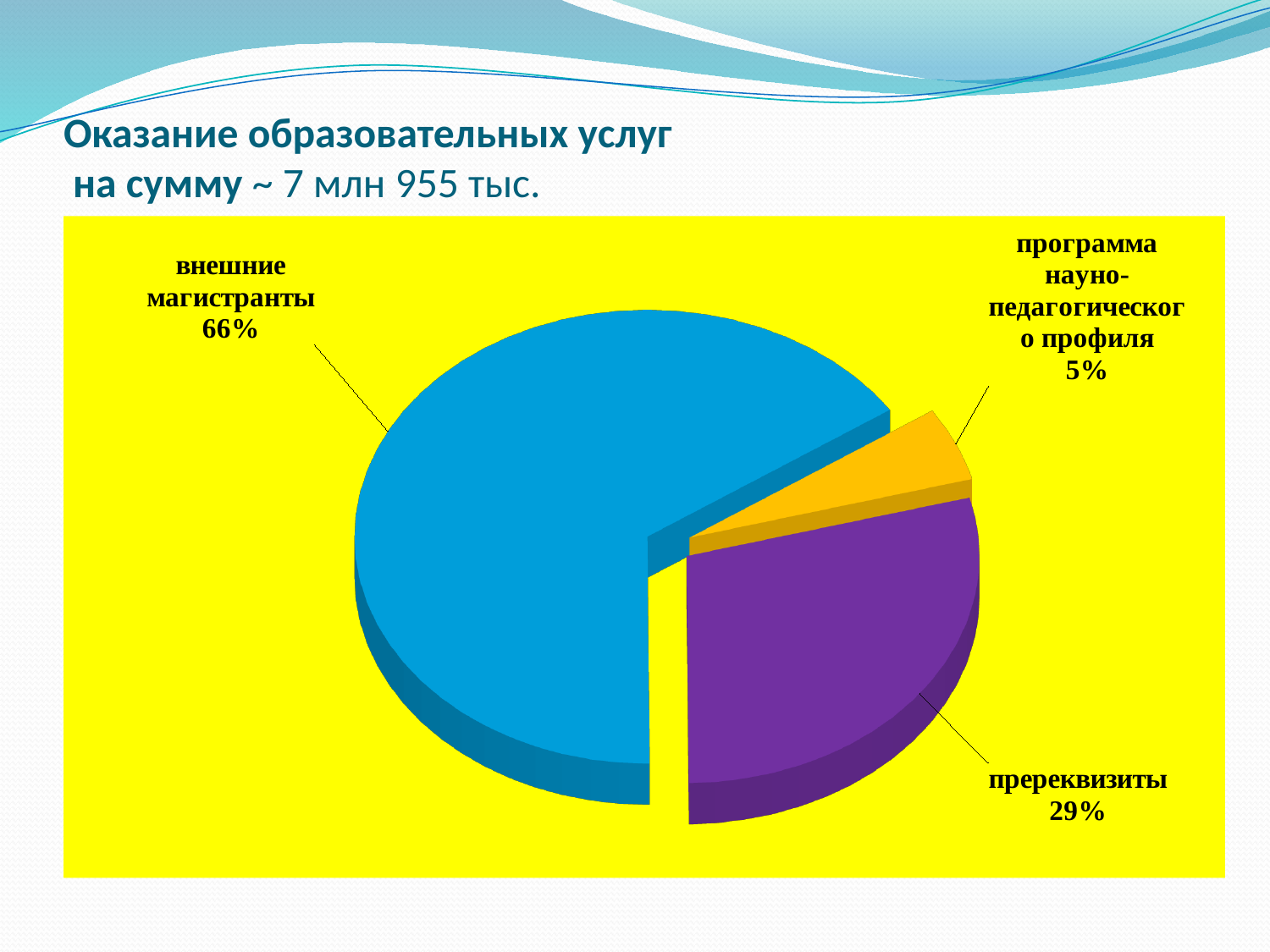
Which category has the largest slice of the pie? внешние магистранты Which category has the smallest slice of the pie? программа науно-педагогического профиля What total sum is stated in the slide title for the educational services? ~ 7 млн 955 тыс. What share of the pie is labelled "пререквизиты"? 29% What colour is the slice for "внешние магистранты"? blue What share of the pie is labelled "программа науно-педагогического профиля"? 5% How many slices does the pie chart have? 3 What share of the pie is labelled "внешние магистранты"? 66% Which is larger, the share for "пререквизиты" or the share for "программа науно-педагогического профиля"? пререквизиты What is the difference in percentage points between "пререквизиты" and "программа науно-педагогического профиля"? 24 What kind of chart is shown on the slide? pie chart What is the difference in percentage points between "внешние магистранты" and "пререквизиты"? 37